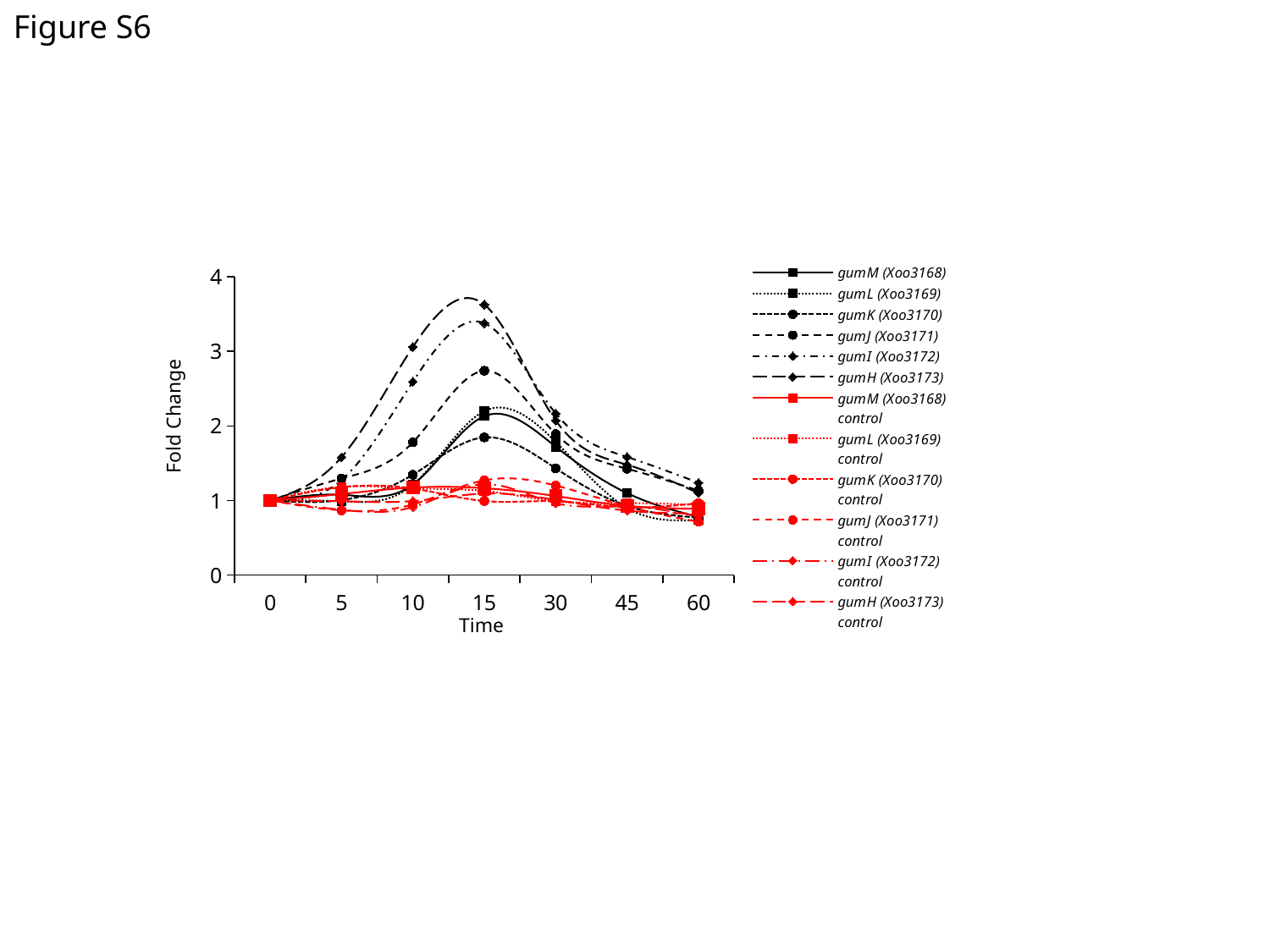
How many series does the legend list? 12 What is the fold change for gumH (Xoo3173) control at time 0? 1 How many time points are plotted along the x axis? 7 Is the value for gumK (Xoo3170) control at time 30 greater or less than 2? less What kind of chart is shown on the slide? line chart What is the label of the y axis? Fold Change What colour are the control series drawn in? red Is the value for gumH (Xoo3173) at time 15 greater or less than 3? greater At time 15, which is larger: gumH (Xoo3173) or gumH (Xoo3173) control? gumH (Xoo3173) Between time 15 and time 60, does the value for gumH (Xoo3173) rise or fall? fall What is the fold change for gumM (Xoo3168) at time 0? 1 Is the value for gumM (Xoo3168) control at time 15 greater or less than 2? less